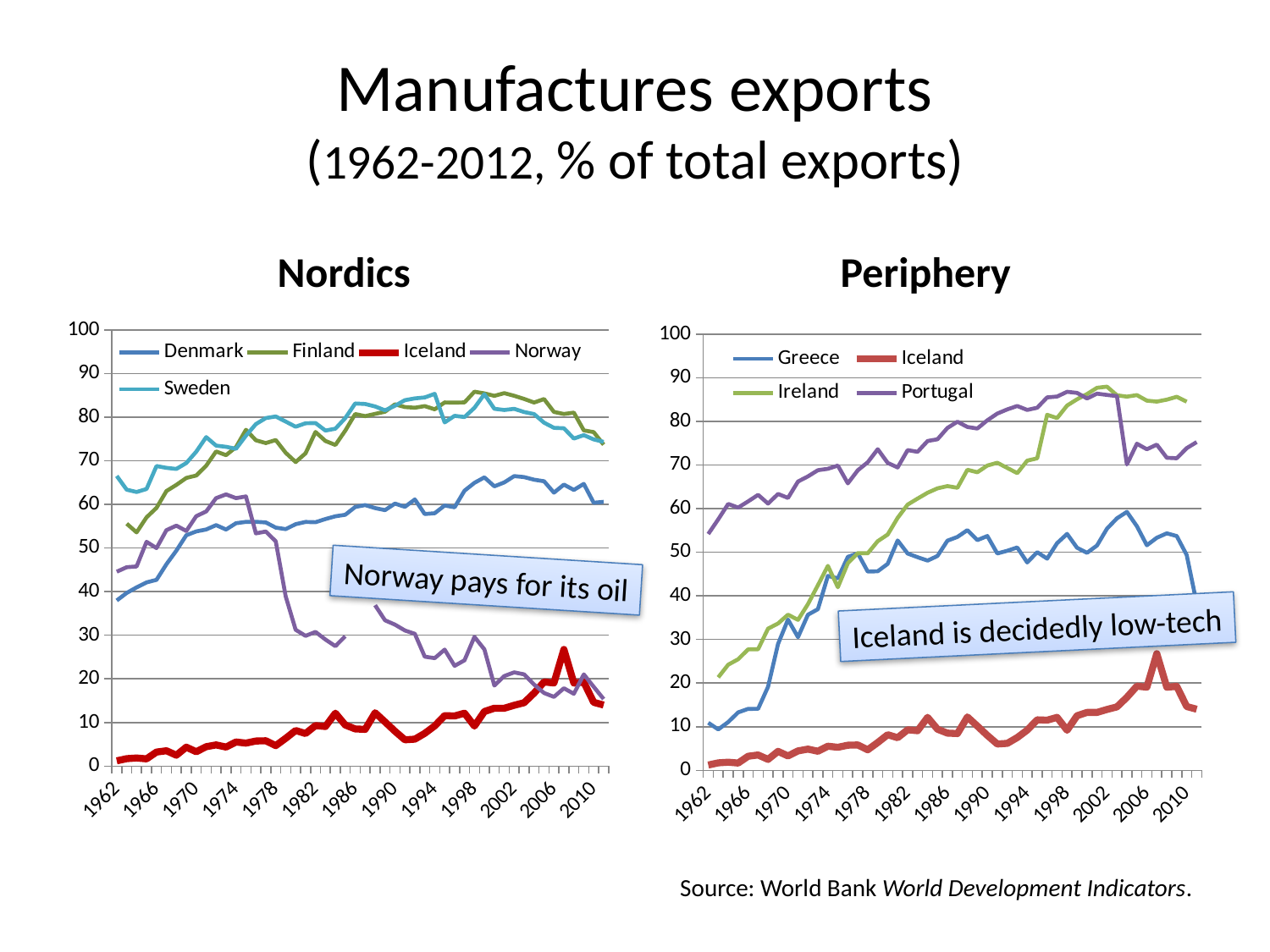
What kind of chart is the Nordics chart? Line chart In the Periphery chart, which series is highest in 1962? Portugal In the Nordics chart, which is higher in 1962, Sweden or Denmark? Sweden What does the annotation on the Nordics chart say? Norway pays for its oil In the Nordics chart, does the Norway series rise or fall between 1978 and 1982? Fall In the Periphery chart, is the value for Ireland in 2002 greater or less than 80? greater How many series does the legend of the Periphery chart list? 4 In the Periphery chart, is the value for Greece in 1962 greater or less than 20? less In the Nordics chart, is the value for Sweden in 1962 greater or less than 60? greater How many series does the legend of the Nordics chart list? 5